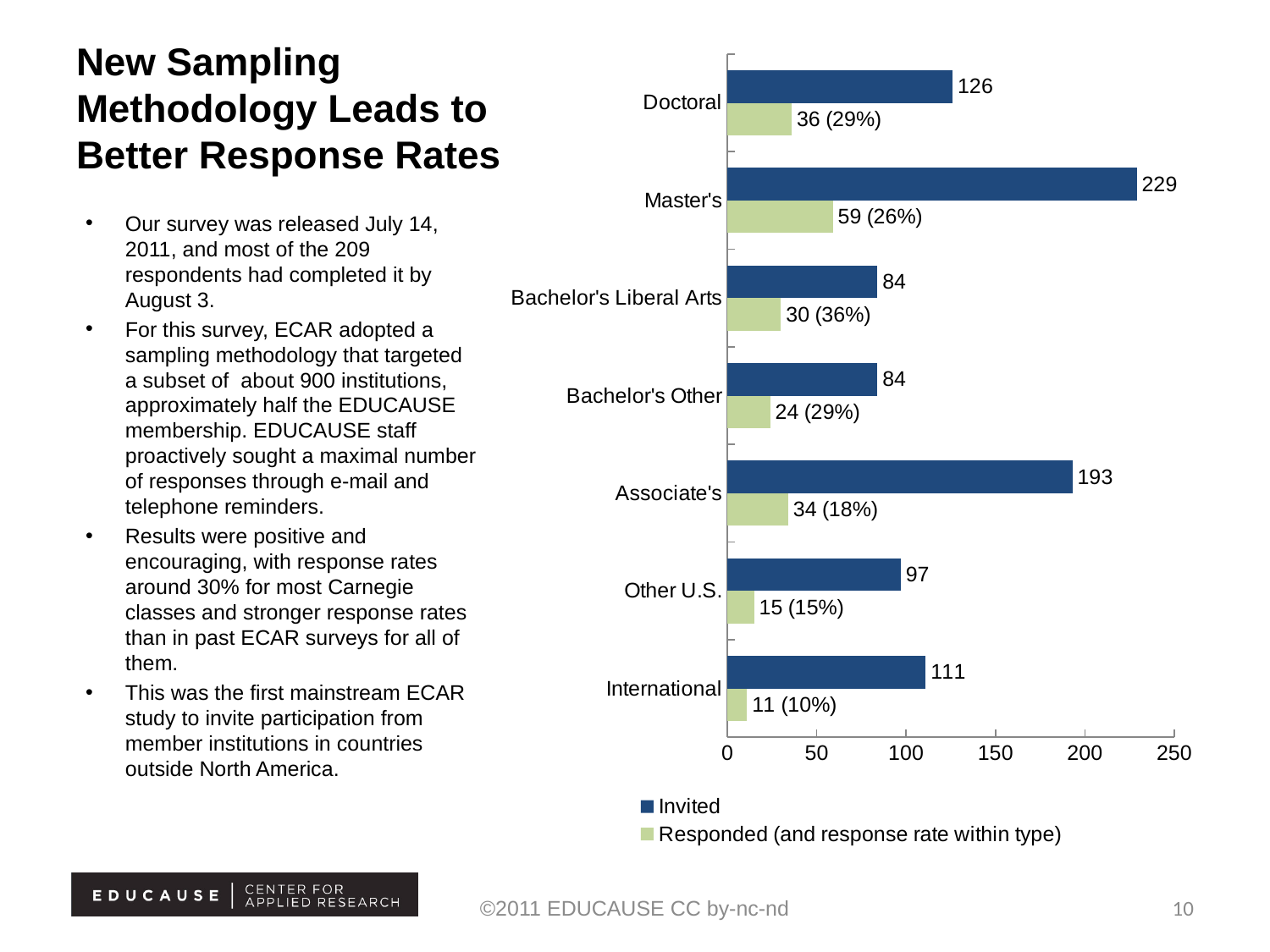
What is the difference between the number invited and the number responded in the Doctoral category? 90 What kind of chart is shown on the slide? bar chart How many categories are shown on the chart? 7 How many institutions were invited in the Master's category? 229 Which category has the lowest number of responded institutions? International Which category has more invited institutions, Associate's or Doctoral? Associate's What is the data label for the Responded bar in the Associate's category? 34 (18%) Is the number of invited institutions for Other U.S. greater or less than 100? less Which category has the highest number of invited institutions? Master's How many institutions were invited in the International category? 111 How many series does the legend list? 2 What is the second legend entry on the chart? Responded (and response rate within type)